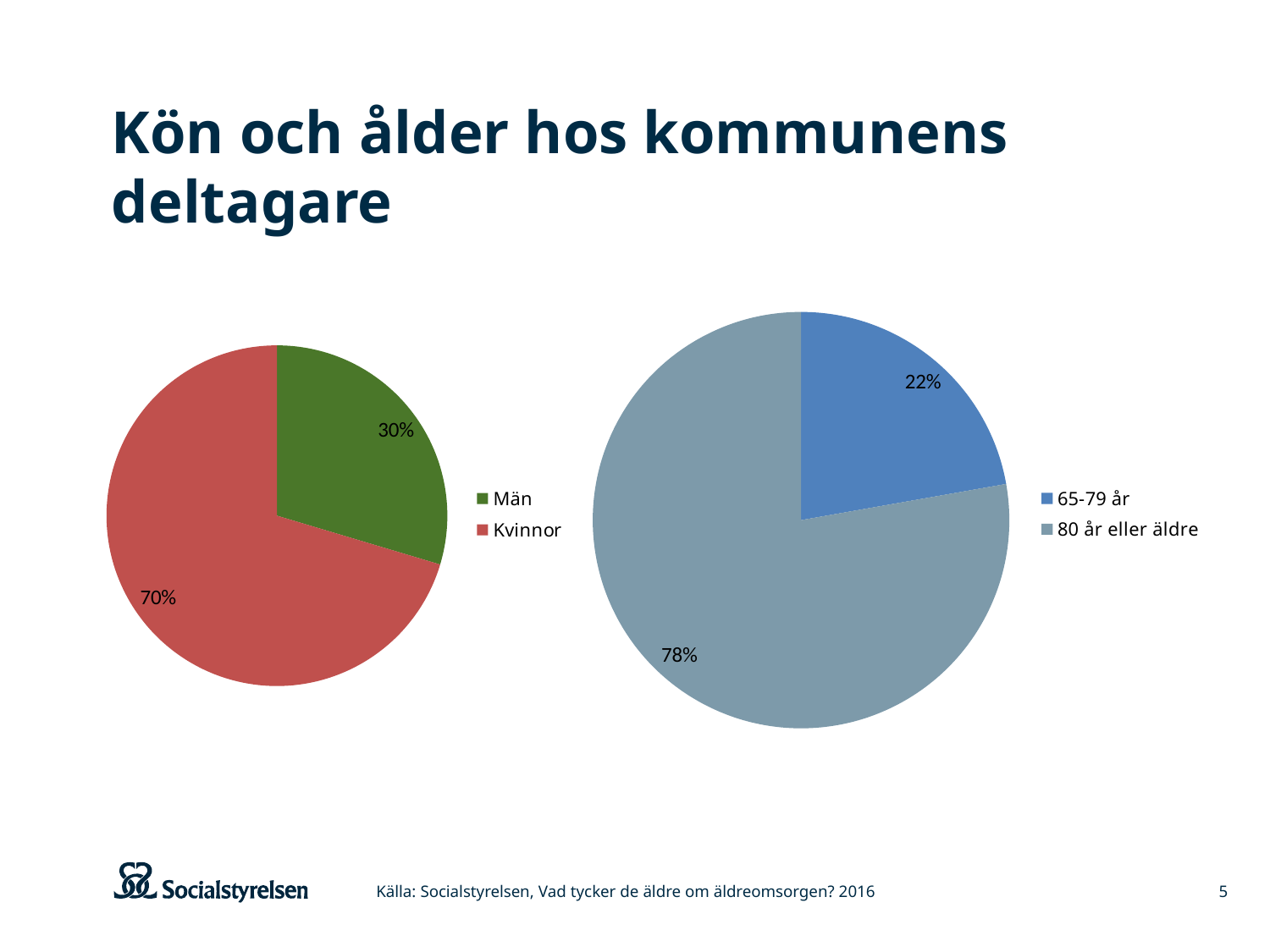
In the left pie chart (gender), what is the difference in percentage points between Kvinnor and Män? 40 In the right pie chart (age), what share is labelled for 65-79 år? 22% In the left pie chart (gender), which category has the largest slice? Kvinnor In the right pie chart (age), which is larger, 65-79 år or 80 år eller äldre? 80 år eller äldre In the left pie chart (gender), what share is labelled for Kvinnor? 70% In the right pie chart (age), what share is labelled for 80 år eller äldre? 78% How many slices does the left pie chart (gender) have? 2 In the left pie chart (gender), what share is labelled for Män? 30% In the right pie chart (age), what colour is the slice for 65-79 år? Blue In the right pie chart (age), which category has the smallest slice? 65-79 år In the right pie chart (age), what is the difference in percentage points between 80 år eller äldre and 65-79 år? 56 What type of chart is used on the right side of the slide? Pie chart